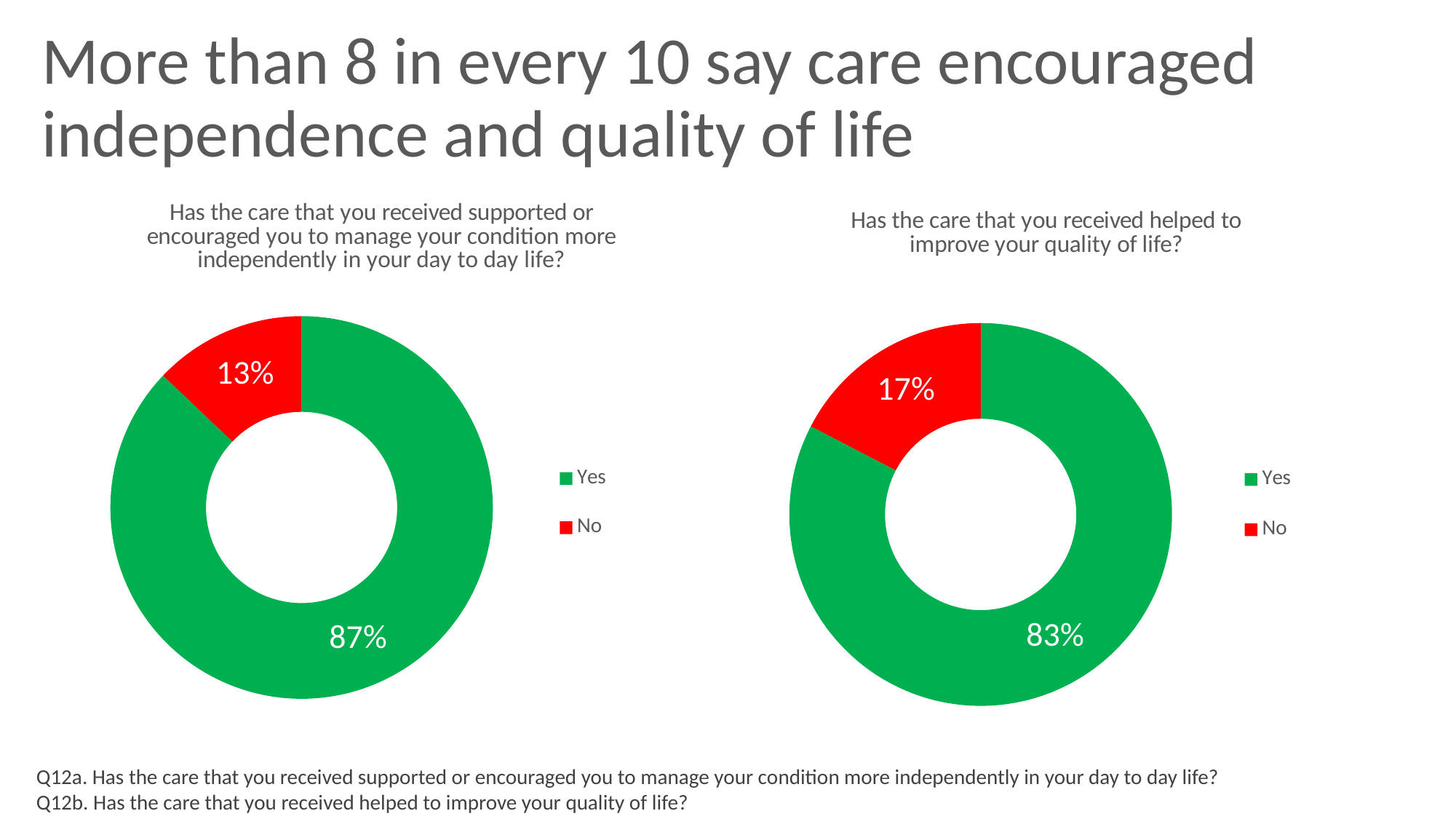
In the left chart (managing condition more independently), what colour represents the No response? Red Which chart has the larger Yes share, the left chart (managing condition more independently) or the right chart (improve your quality of life)? The left chart What type of chart is used on the left of the slide? Doughnut chart In the right chart (improve your quality of life), which response has the smallest share? No How many entries does the legend of the right chart (improve your quality of life) list? 2 In the right chart (improve your quality of life), what percentage answered Yes? 83% In the left chart (managing condition more independently), what percentage answered No? 13% In the left chart (managing condition more independently), which response has the largest share? Yes In the right chart (improve your quality of life), what is the difference between the Yes and No percentages? 66% In the left chart (managing condition more independently), what percentage answered Yes? 87% In the left chart (managing condition more independently), what is the difference between the Yes and No percentages? 74% In the right chart (improve your quality of life), what percentage answered No? 17%